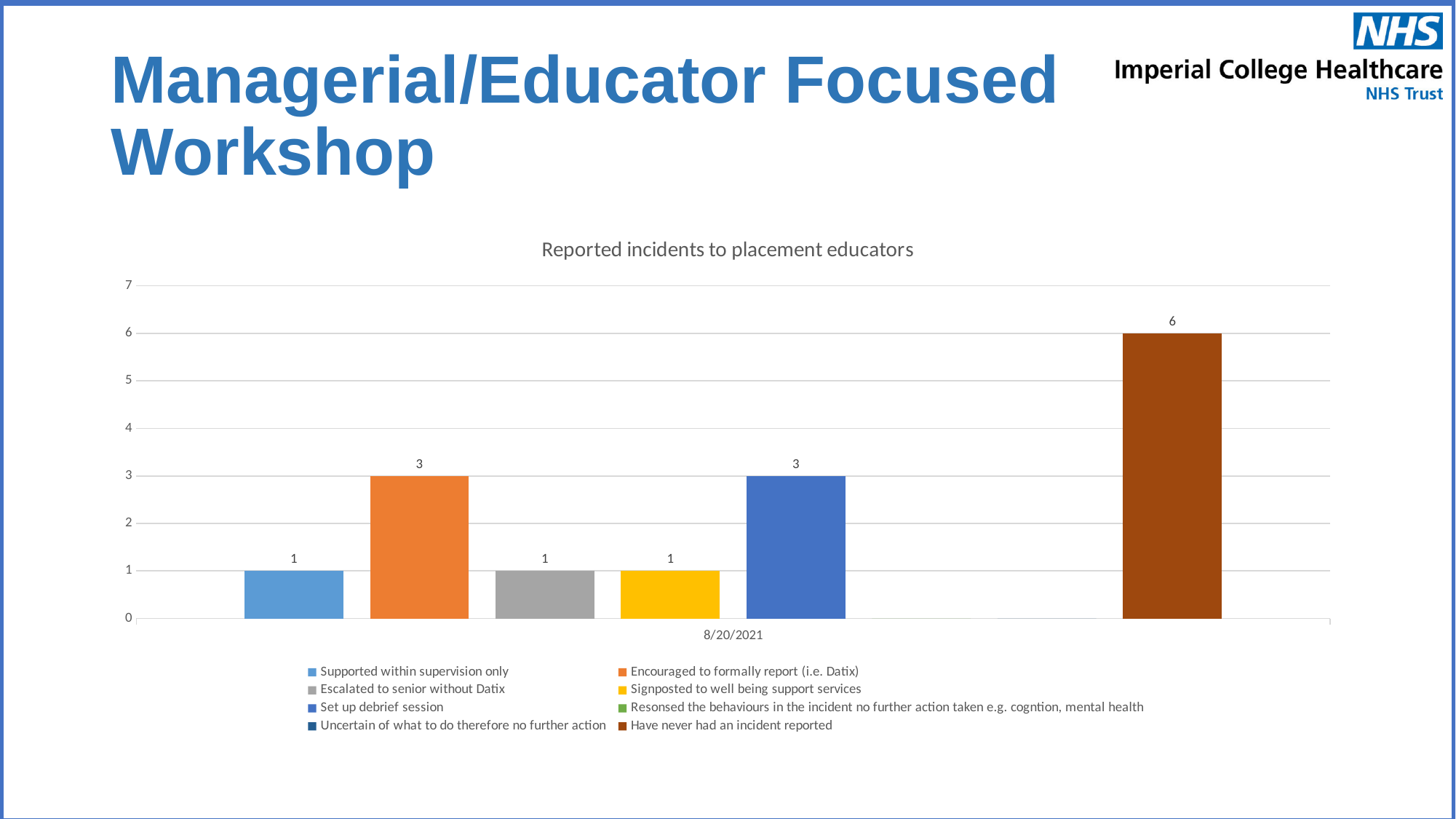
What date label is shown on the x axis? 8/20/2021 Is the value for 'Have never had an incident reported' greater or less than 5? greater Which is larger: 'Encouraged to formally report (i.e. Datix)' or 'Escalated to senior without Datix'? Encouraged to formally report (i.e. Datix) How many series does the legend list? 8 What is the value for 'Set up debrief session'? 3 What is the title of the chart? Reported incidents to placement educators What is the difference between 'Have never had an incident reported' and 'Set up debrief session'? 3 What is the value for 'Encouraged to formally report (i.e. Datix)'? 3 What is the value for 'Have never had an incident reported'? 6 Which series has the highest value? Have never had an incident reported What is the value for 'Supported within supervision only'? 1 What type of chart is shown on the slide? Bar chart